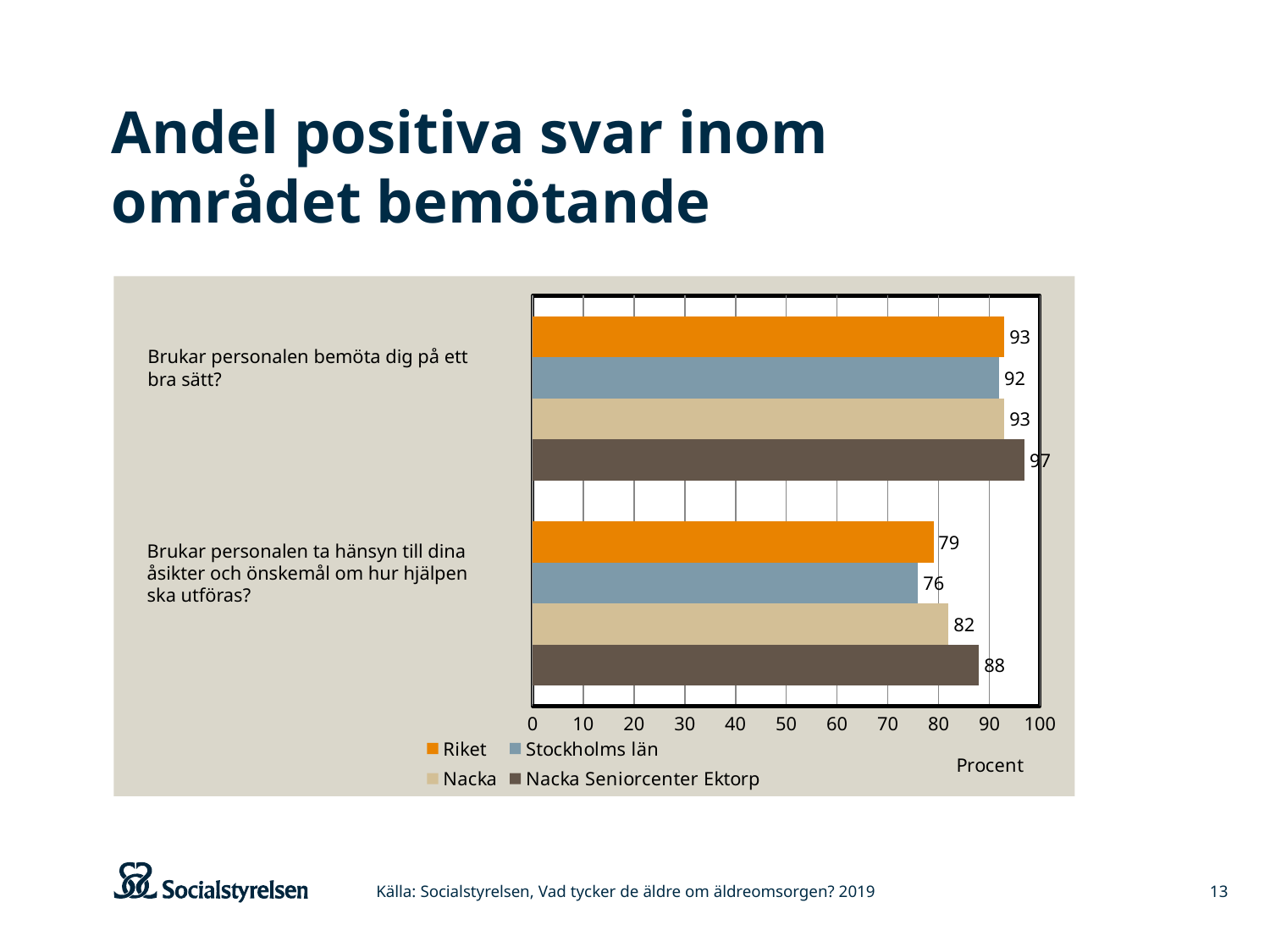
What is the value for Nacka Seniorcenter Ektorp for the question "Brukar personalen ta hänsyn till dina åsikter och önskemål om hur hjälpen ska utföras?"? 88 What kind of chart is shown on the slide? Bar chart What is the value for Stockholms län for the question "Brukar personalen ta hänsyn till dina åsikter och önskemål om hur hjälpen ska utföras?"? 76 How many series does the legend list? 4 What is the value for Riket for the question "Brukar personalen bemöta dig på ett bra sätt?"? 93 Which series has the highest value for the question "Brukar personalen bemöta dig på ett bra sätt?"? Nacka Seniorcenter Ektorp Which series has the lowest value for the question "Brukar personalen ta hänsyn till dina åsikter och önskemål om hur hjälpen ska utföras?"? Stockholms län What is the label on the horizontal axis of the chart? Procent What is the value for Nacka for the question "Brukar personalen bemöta dig på ett bra sätt?"? 93 How many questions (categories) are shown on the chart? 2 What is the difference between the Nacka Seniorcenter Ektorp value and the Riket value for the question "Brukar personalen ta hänsyn till dina åsikter och önskemål om hur hjälpen ska utföras?"? 9 For the question "Brukar personalen ta hänsyn till dina åsikter och önskemål om hur hjälpen ska utföras?", which is larger: the value for Nacka or the value for Riket? Nacka